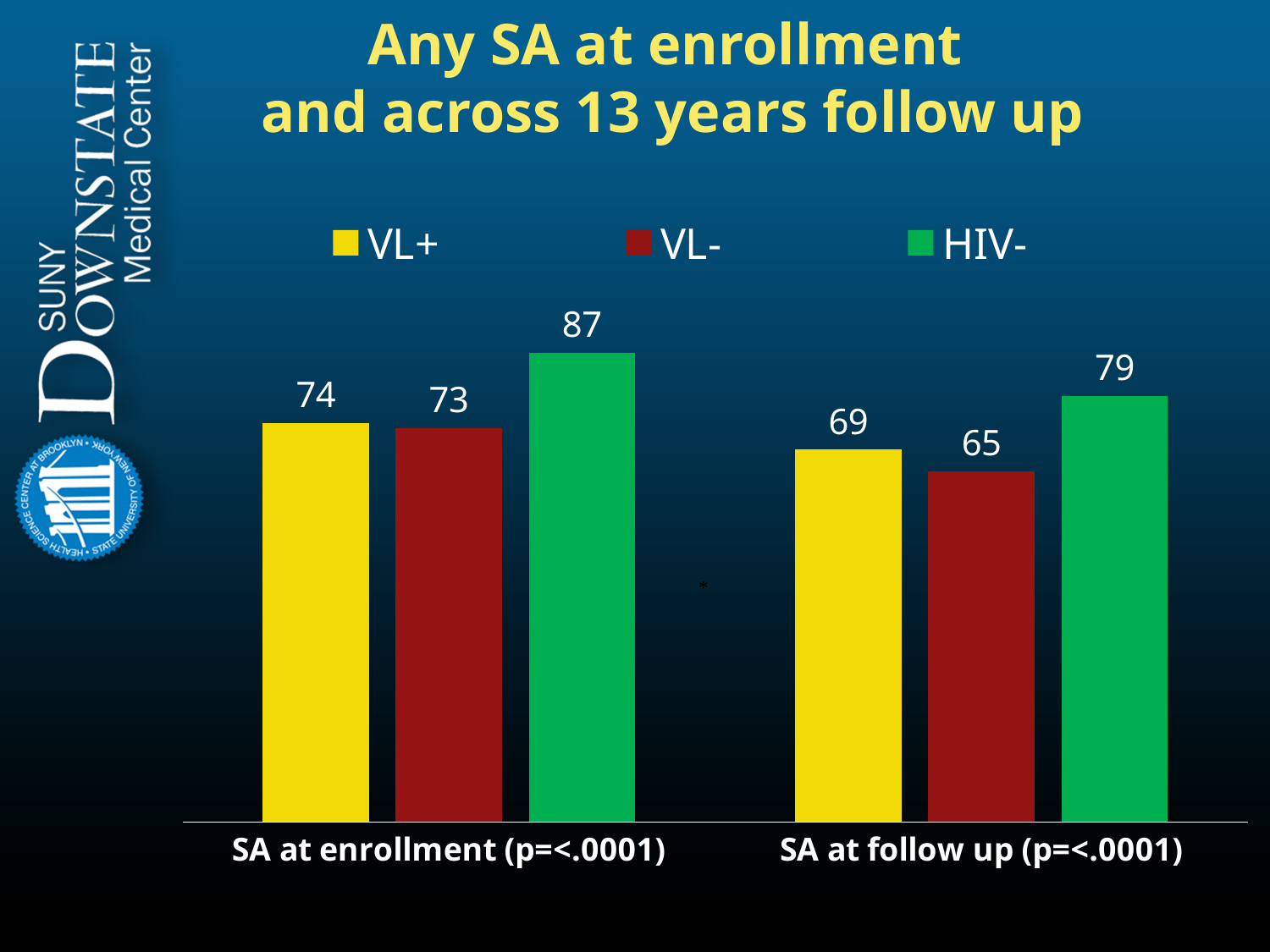
What is the value for VL- in the SA at follow up (p=<.0001) category? 65 What is the value for VL+ in the SA at follow up (p=<.0001) category? 69 Which is larger: the VL- value at SA at enrollment or the VL- value at SA at follow up? SA at enrollment Which series has the highest value in the SA at enrollment (p=<.0001) category? HIV- Which series has the lowest value in the SA at follow up (p=<.0001) category? VL- How many categories are shown on the x axis? 2 What kind of chart is shown on the slide? Bar chart What is the difference between the VL+ value at SA at enrollment and the VL+ value at SA at follow up? 5 What is the difference between the HIV- value and the VL- value in the SA at enrollment (p=<.0001) category? 14 What is the value for HIV- in the SA at enrollment (p=<.0001) category? 87 How many series does the legend list? 3 Which colour represents the HIV- series in the legend? Green